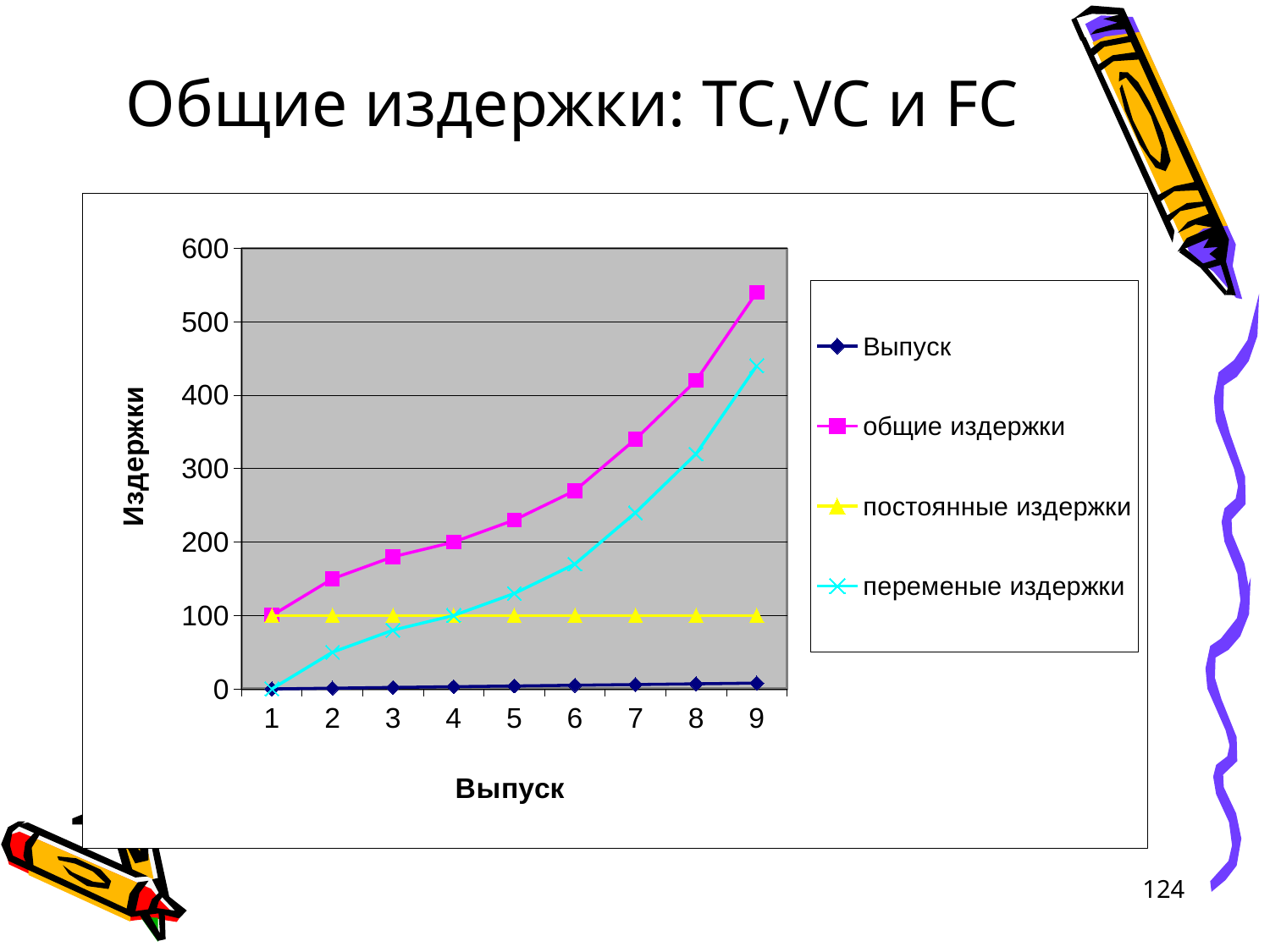
What is the value of постоянные издержки at Выпуск 5? 100 Which series has the highest value at Выпуск 9? общие издержки What kind of chart is shown on the slide? line chart At Выпуск 6, which is larger: общие издержки or переменые издержки? общие издержки Is the value of переменые издержки at Выпуск 2 greater or less than 100? less How many series does the legend list? 4 Is the value of общие издержки at Выпуск 7 greater or less than 300? greater Do the values of общие издержки rise or fall as Выпуск increases from 1 to 9? rise What is the value of общие издержки at Выпуск 4? 200 What is the difference between общие издержки and постоянные издержки at Выпуск 4? 100 How many points are plotted along the x axis (Выпуск)? 9 Is the value of общие издержки at Выпуск 9 greater or less than 500? greater